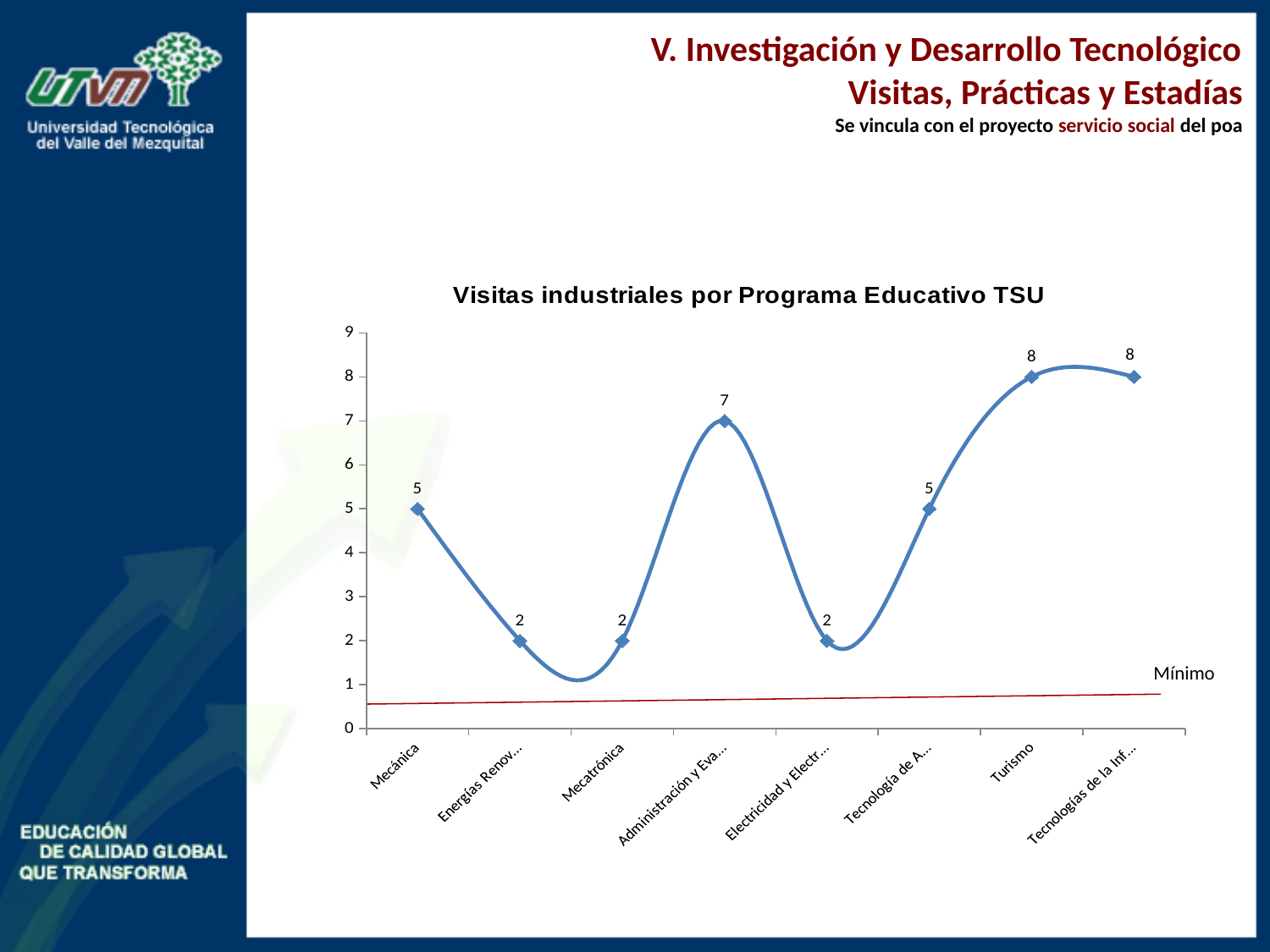
Is the value for Turismo greater or less than 6? greater What is the difference between the values for Turismo and Mecánica? 3 What is the difference between the values for Administración y Eva... and Mecatrónica? 5 What is the value for Mecatrónica? 2 How many programs (categories) are plotted on the x axis? 8 What is the value for Turismo? 8 What label is shown next to the red line at the bottom of the chart? Mínimo Which is larger, the value for Mecánica or the value for Mecatrónica? Mecánica What is the value for Mecánica? 5 What is the title of the chart? Visitas industriales por Programa Educativo TSU What type of chart is shown on the slide? line chart What is the value for Administración y Eva...? 7